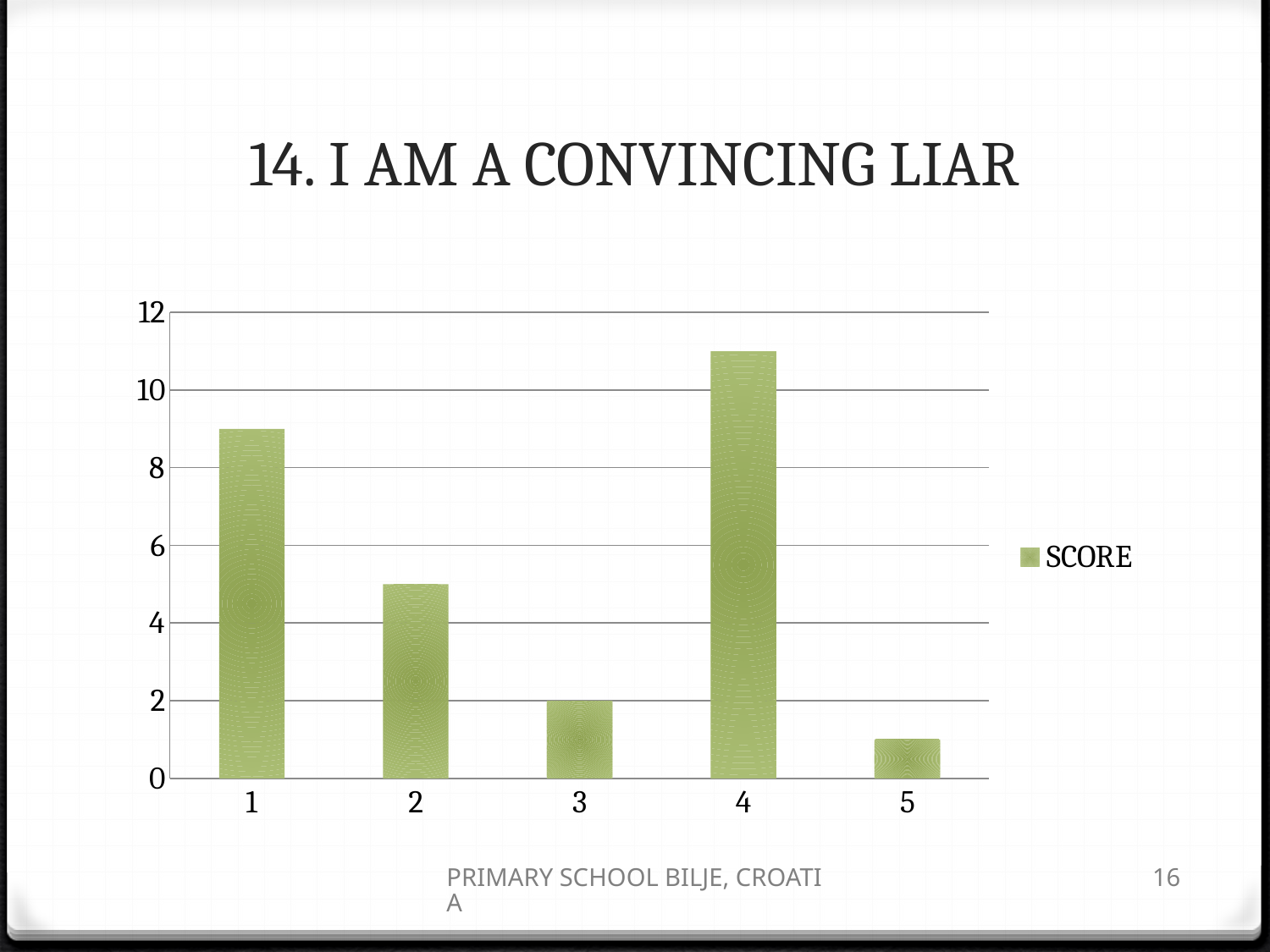
How many categories are shown on the x axis of the chart? 5 Is the SCORE for category 4 greater or less than 10? greater What is the title of the chart's slide? 14. I AM A CONVINCING LIAR Which has a higher SCORE, category 1 or category 2? 1 Which category has the highest SCORE? 4 Is the SCORE for category 5 greater or less than 2? less What is the SCORE for category 3? 2 Is the SCORE for category 1 greater or less than 8? greater Which category has the lowest SCORE? 5 What kind of chart is shown on the slide? bar chart How many series does the legend list? 1